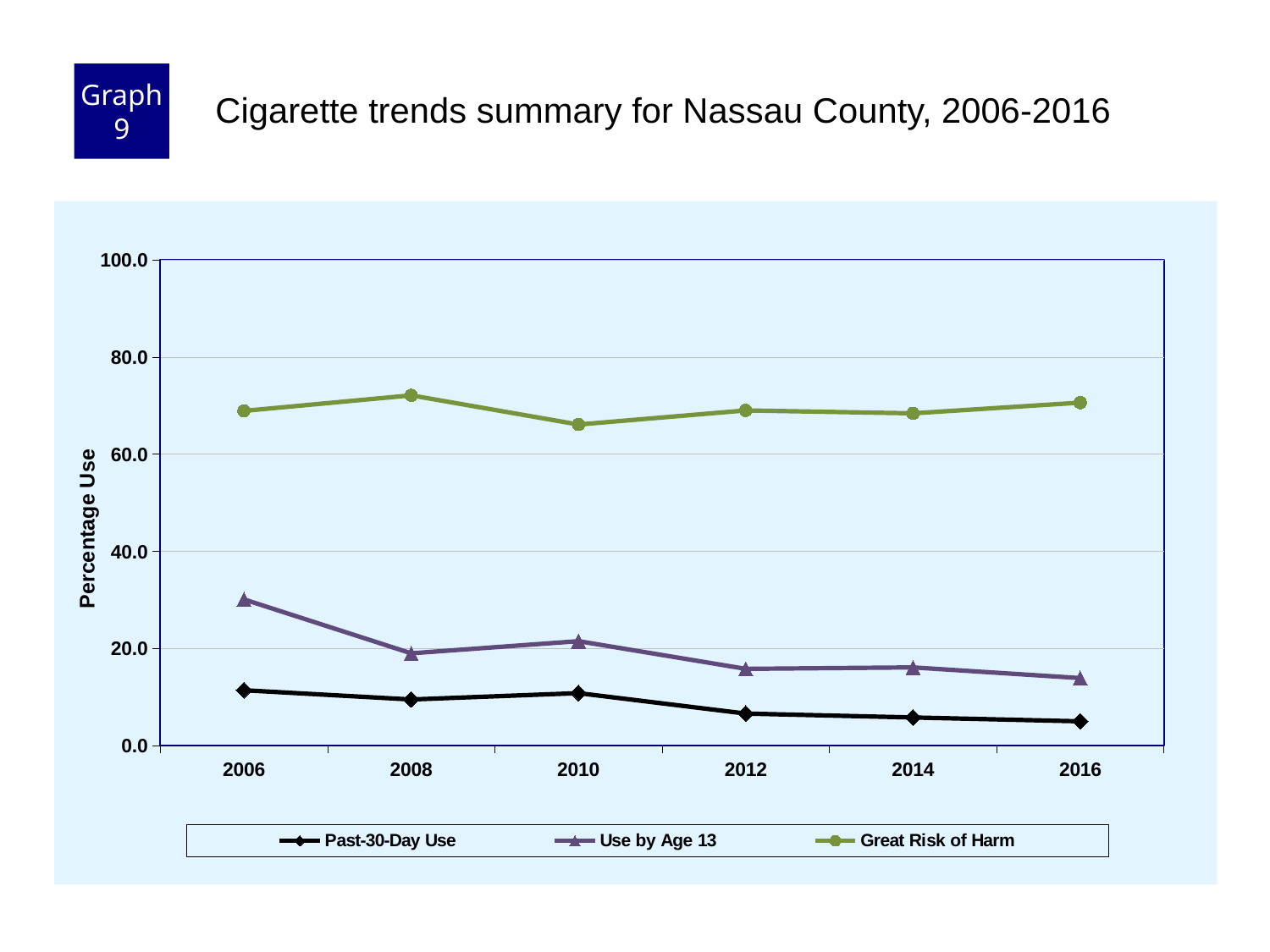
Is the value for Use by Age 13 in 2006 greater or less than 20.0? greater In which year is Great Risk of Harm at its lowest? 2010 Is the value for Great Risk of Harm in 2010 greater or less than 60.0? greater In which year is Use by Age 13 at its highest? 2006 In 2010, which is larger: Use by Age 13 or Past-30-Day Use? Use by Age 13 Does Past-30-Day Use rise or fall overall from 2006 to 2016? fall What is the title of the y axis? Percentage Use What kind of chart is shown on the slide? Line chart How many series does the legend list? 3 Is the value for Past-30-Day Use in 2016 greater or less than 20.0? less How many years are plotted along the x axis? 6